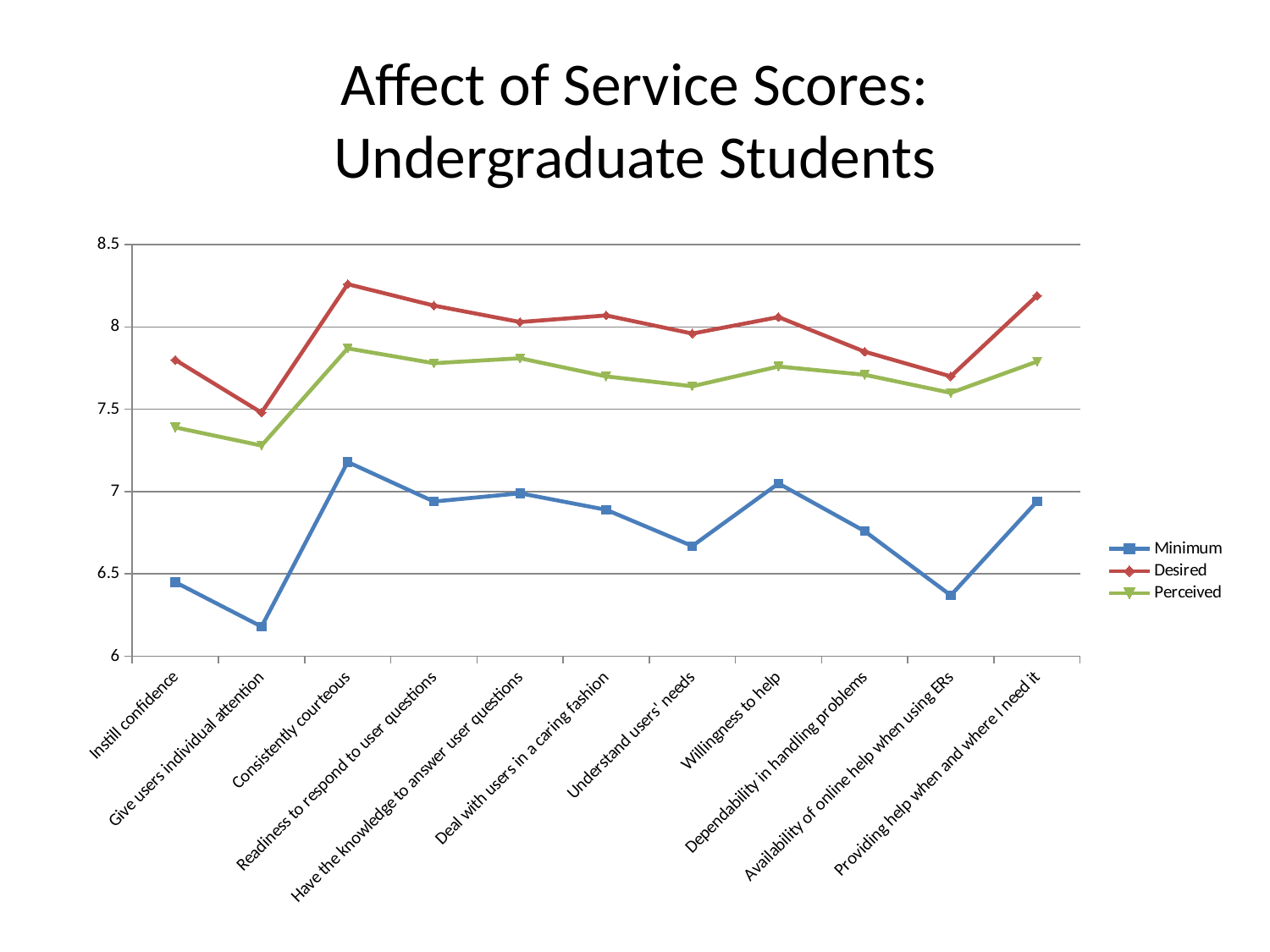
For which category is the Desired series lowest? Give users individual attention For which category is the Minimum series lowest? Give users individual attention Is the Minimum value for Consistently courteous greater or less than 7? greater How many categories are plotted along the x axis? 11 What colour is the Desired series line? Red Does the Minimum series rise or fall from Instill confidence to Give users individual attention? Fall Which is larger for Instill confidence, the Desired value or the Perceived value? Desired How many series does the legend list? 3 What kind of chart is shown on the slide? Line chart For which category is the Desired series highest? Consistently courteous Is the Minimum value for Availability of online help when using ERs greater or less than 6.5? less